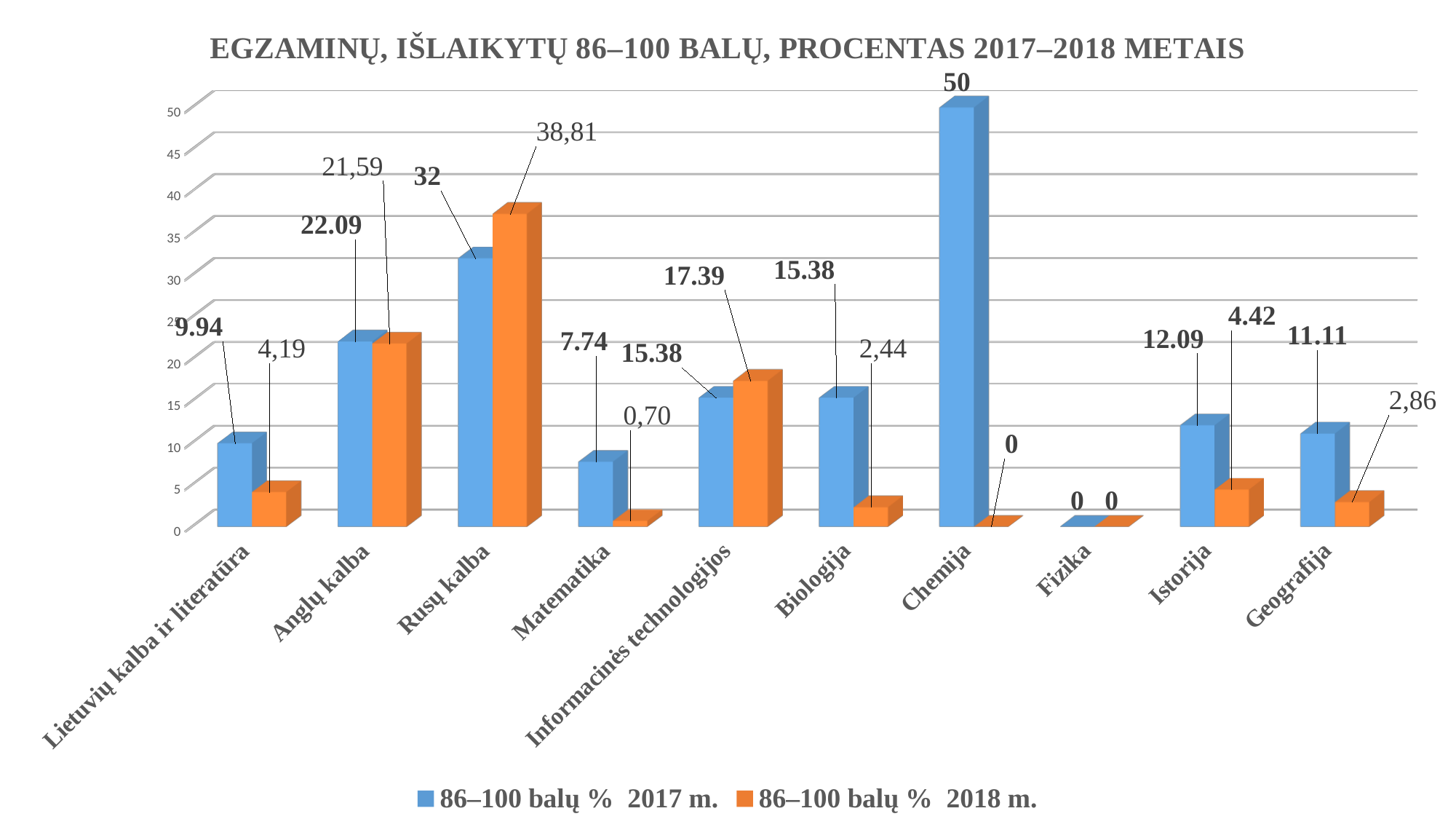
What kind of chart is shown on the slide? bar chart Which subject has the highest value in the 86–100 balų % 2017 m. series? Chemija How many subjects are shown on the x axis? 10 Is the value for Rusų kalba in the 2018 m. series greater or less than 35? greater What is the value for Rusų kalba in the 86–100 balų % 2018 m. series? 38,81 How many series does the legend list? 2 Which subject has the lowest value in the 86–100 balų % 2017 m. series? Fizika What is the value for Chemija in the 86–100 balų % 2017 m. series? 50 What is the difference between the 2017 and 2018 values for Istorija? 7.67 What is the value for Matematika in the 86–100 balų % 2018 m. series? 0,70 Which subject has the highest value in the 86–100 balų % 2018 m. series? Rusų kalba For Informacinės technologijos, which series has the larger value, 2017 m. or 2018 m.? 2018 m.